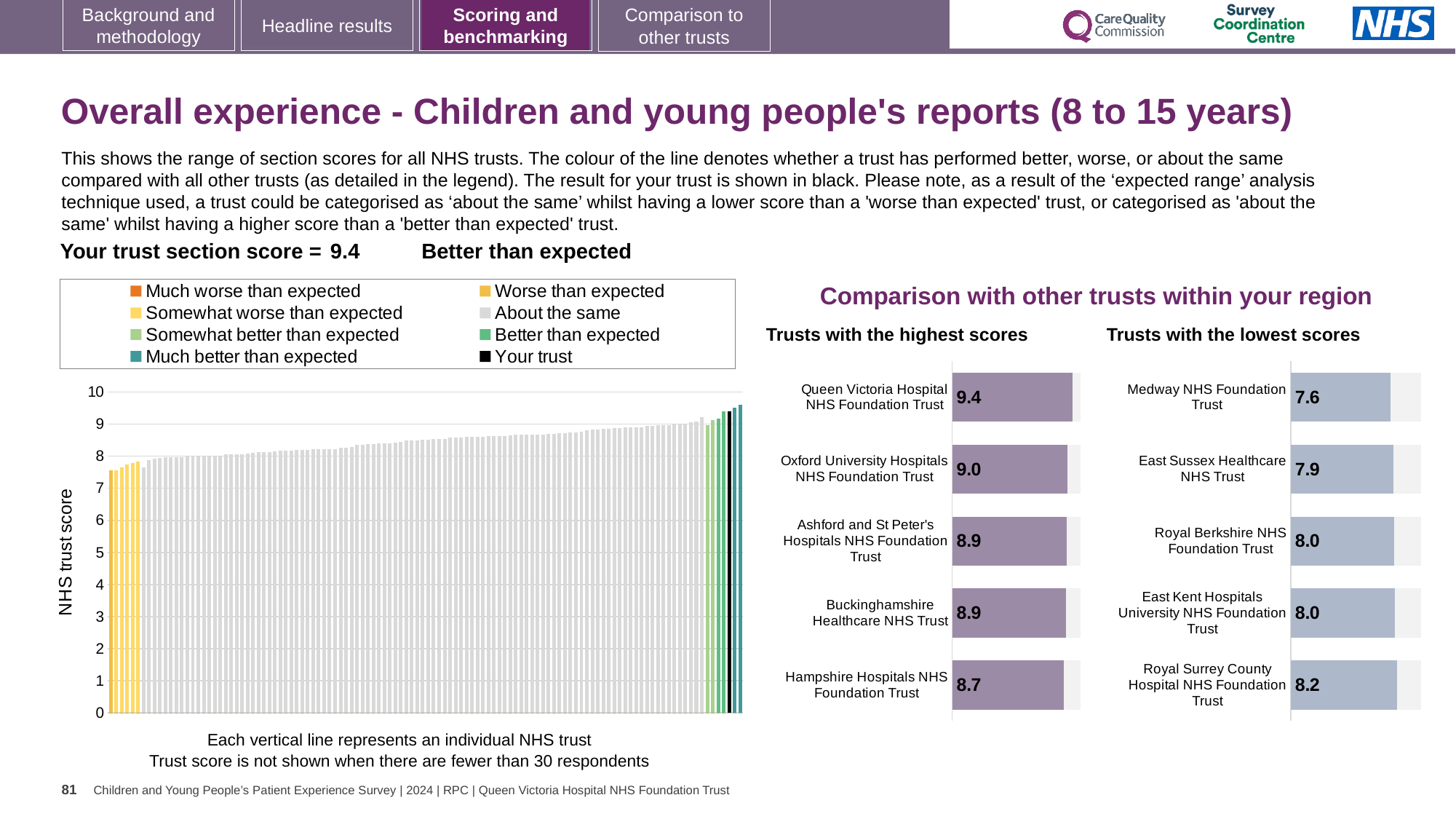
In the 'Trusts with the lowest scores' chart, what is the score for Medway NHS Foundation Trust? 7.6 In the 'Trusts with the highest scores' chart, what is the score for Queen Victoria Hospital NHS Foundation Trust? 9.4 In the NHS trust score chart on the left, is the value of the lowest (leftmost) bar greater or less than 8? less How many entries does the legend of the NHS trust score chart on the left list? 8 In the NHS trust score chart on the left, do the bar values rise or fall from left to right? rise In the 'Trusts with the lowest scores' chart, how many trusts are shown? 5 In the 'Trusts with the lowest scores' chart, what is the difference between the scores of Royal Surrey County Hospital NHS Foundation Trust and Medway NHS Foundation Trust? 0.6 In the 'Trusts with the highest scores' chart, what is the difference between the scores of Queen Victoria Hospital NHS Foundation Trust and Hampshire Hospitals NHS Foundation Trust? 0.7 In the 'Trusts with the highest scores' chart, which has the higher score: Queen Victoria Hospital NHS Foundation Trust or Oxford University Hospitals NHS Foundation Trust? Queen Victoria Hospital NHS Foundation Trust In the 'Trusts with the highest scores' chart, what is the score for Hampshire Hospitals NHS Foundation Trust? 8.7 In the 'Trusts with the lowest scores' chart, which trust has the lowest score? Medway NHS Foundation Trust In the 'Trusts with the lowest scores' chart, which trust has the highest score? Royal Surrey County Hospital NHS Foundation Trust